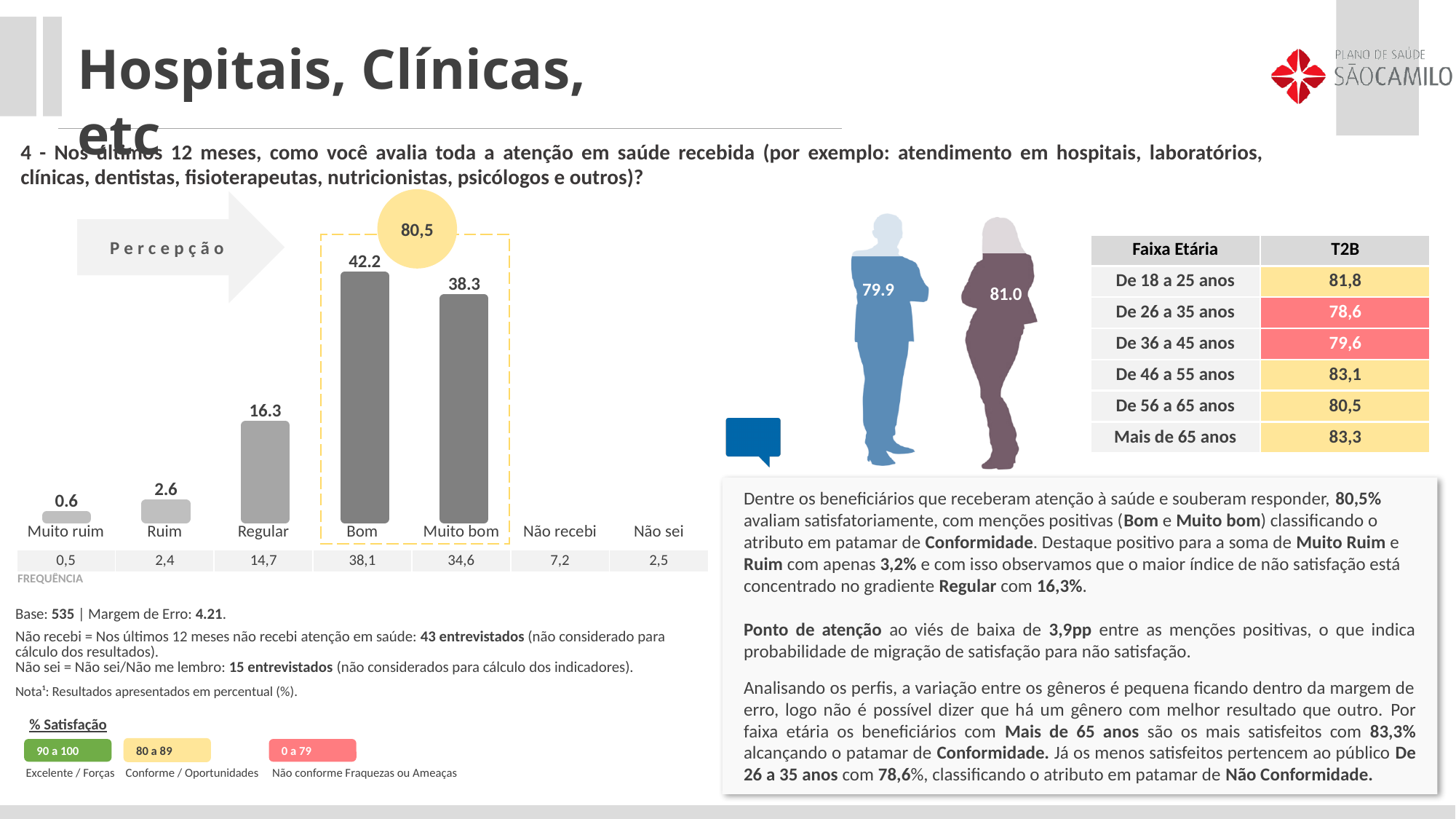
Which category has the highest bar in the bar chart? Bom What is the value shown for the 'Bom' bar in the bar chart? 42.2 What type of chart is used to show the perception results on the slide? Bar chart What is the value shown for the 'Regular' bar in the bar chart? 16.3 What is the frequency value listed below the 'Não recebi' category in the bar chart? 7,2 Which bar is larger in the bar chart, 'Regular' or 'Ruim'? Regular Which category has the lowest bar in the bar chart? Muito ruim What is the difference between the 'Bom' and 'Muito bom' bars in the bar chart? 3.9 What value is shown in the yellow circle above the 'Bom' and 'Muito bom' bars? 80,5 What is the value shown for the 'Ruim' bar in the bar chart? 2.6 How many bars are plotted in the bar chart? 5 What is the value shown for the 'Muito ruim' bar in the bar chart? 0.6